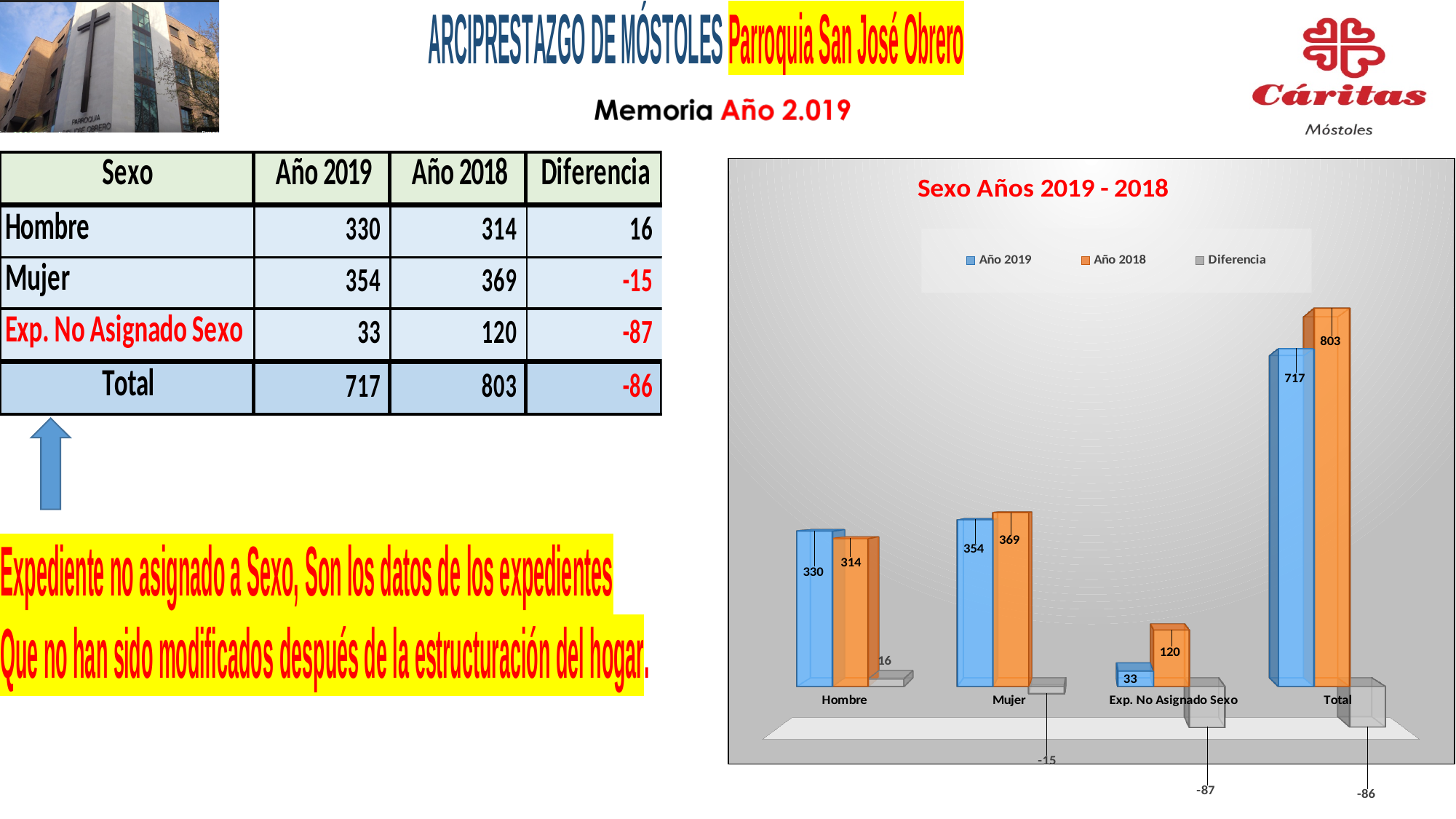
What is the Año 2018 value for Mujer in the chart? 369 What is the Diferencia value for Total in the chart? -86 What is the difference between the Año 2018 and Año 2019 values for Exp. No Asignado Sexo? 87 What is the Año 2019 value for Hombre in the chart? 330 What is the Año 2018 value for Exp. No Asignado Sexo in the chart? 120 How many categories are shown on the x axis of the chart? 4 Which category has the lowest Año 2019 value in the chart? Exp. No Asignado Sexo Which is larger for Mujer: the Año 2019 value or the Año 2018 value? Año 2018 Which series is shown in orange in the chart? Año 2018 How many series does the chart legend list? 3 What type of chart is shown on the slide? bar chart What is the title of the chart? Sexo Años 2019 - 2018